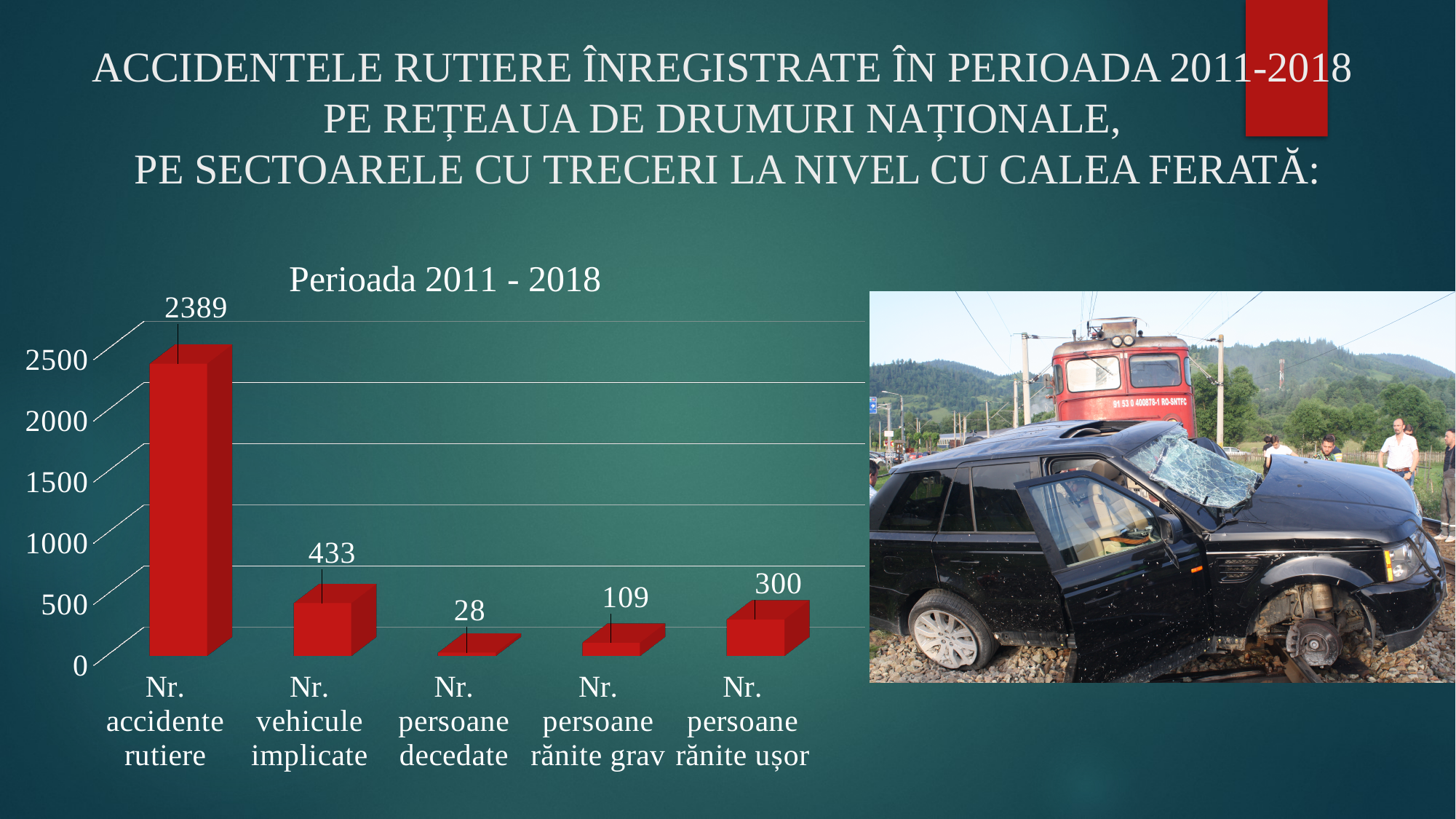
What kind of chart is shown on the slide? Bar chart What is the value for Nr. persoane decedate? 28 What is the value for Nr. persoane rănite grav? 109 What is the difference between Nr. persoane rănite ușor and Nr. persoane rănite grav? 191 Which category has the highest value? Nr. accidente rutiere What is the title of the chart? Perioada 2011 - 2018 What is the value for Nr. accidente rutiere? 2389 Which category has the lowest value? Nr. persoane decedate What is the value for Nr. persoane rănite ușor? 300 How many categories are shown in the chart? 5 What is the value for Nr. vehicule implicate? 433 Which is larger, Nr. vehicule implicate or Nr. persoane rănite ușor? Nr. vehicule implicate